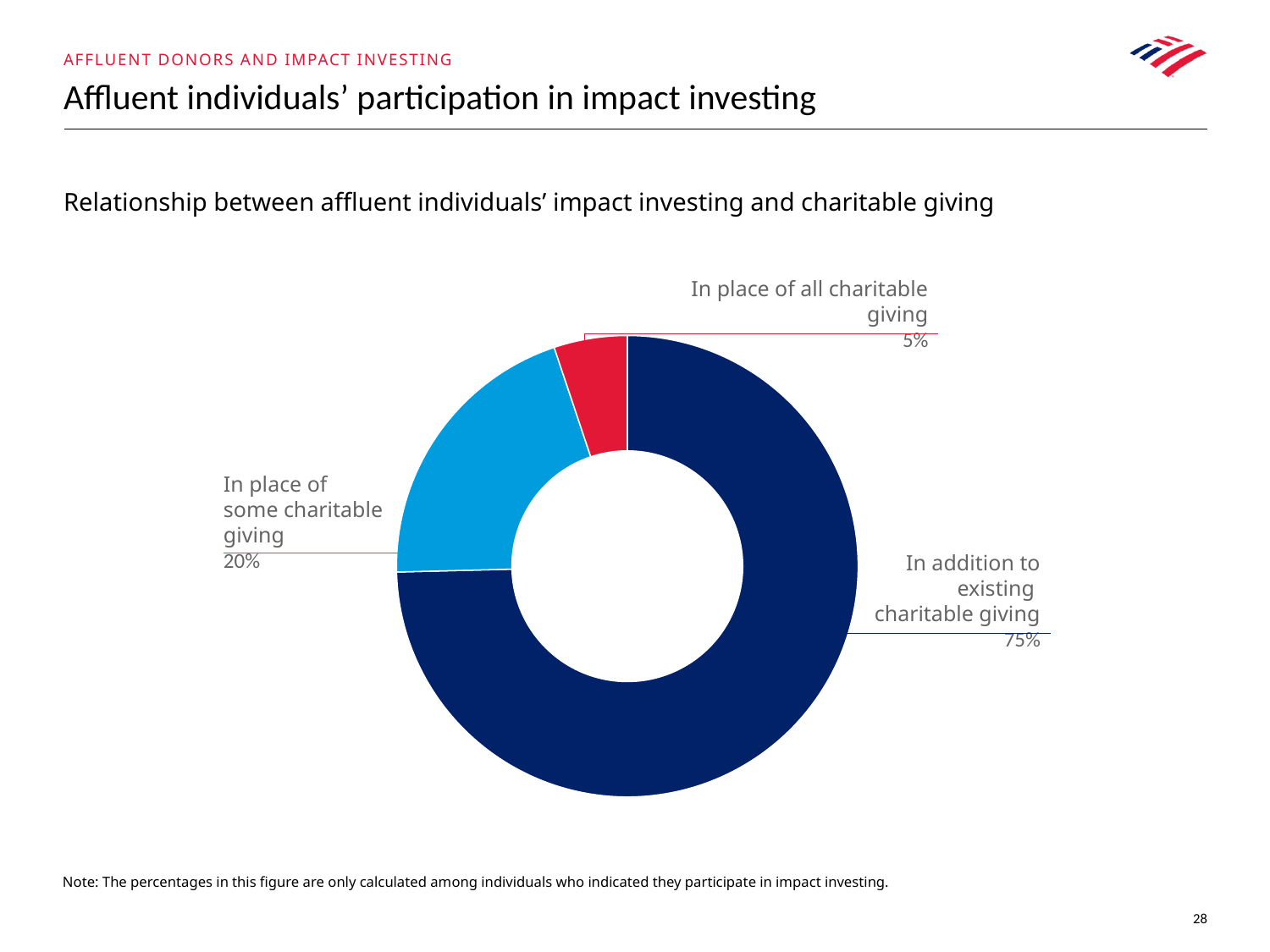
How many categories are shown in the chart? 3 What is the difference in percentage points between 'In place of some charitable giving' and 'In place of all charitable giving'? 15 Which is larger: 'In place of some charitable giving' or 'In place of all charitable giving'? In place of some charitable giving What is the difference in percentage points between 'In addition to existing charitable giving' and 'In place of some charitable giving'? 55 What percentage of affluent individuals do impact investing in place of some charitable giving? 20% Which category has the largest share of the chart? In addition to existing charitable giving What kind of chart is shown on the slide? Doughnut (pie) chart What is the combined share of the two 'in place of' categories? 25% Which category has the smallest share of the chart? In place of all charitable giving What percentage of affluent individuals do impact investing in place of all charitable giving? 5% What colour is the slice for 'In place of all charitable giving'? Red What percentage of affluent individuals do impact investing in addition to existing charitable giving? 75%